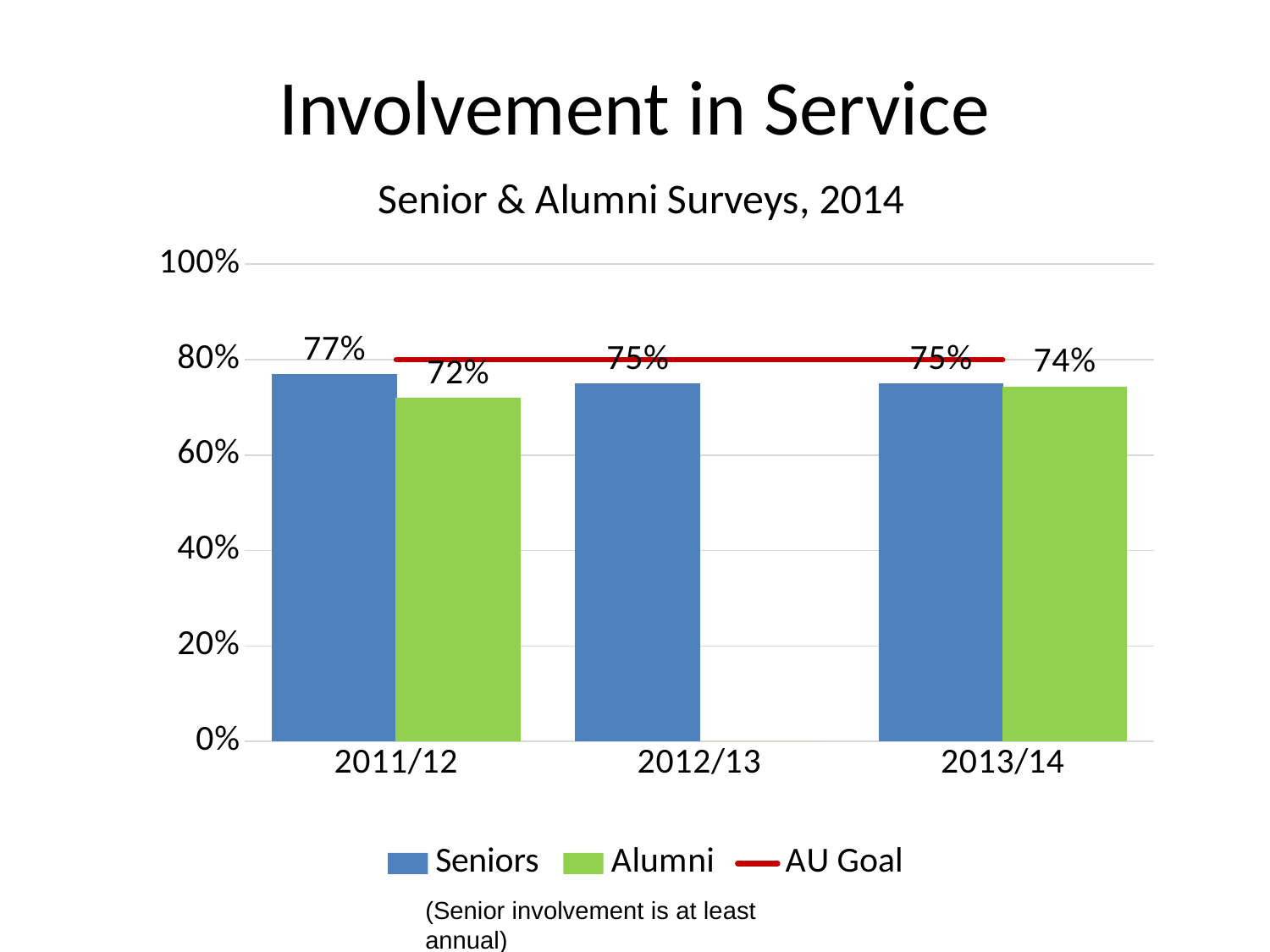
How many year categories are shown on the x axis? 3 What kind of chart is this? combination bar and line chart In which year is the Seniors value highest? 2011/12 What is the value for Alumni in 2011/12? 72% What is the difference between the Seniors and Alumni values in 2011/12? 5% How many series does the legend list? 3 What is the value for Seniors in 2012/13? 75% Is the AU Goal line greater or less than 60%? greater Which is larger in 2013/14, the Seniors value or the Alumni value? Seniors What is the value for Seniors in 2011/12? 77% What is the value for Alumni in 2013/14? 74%